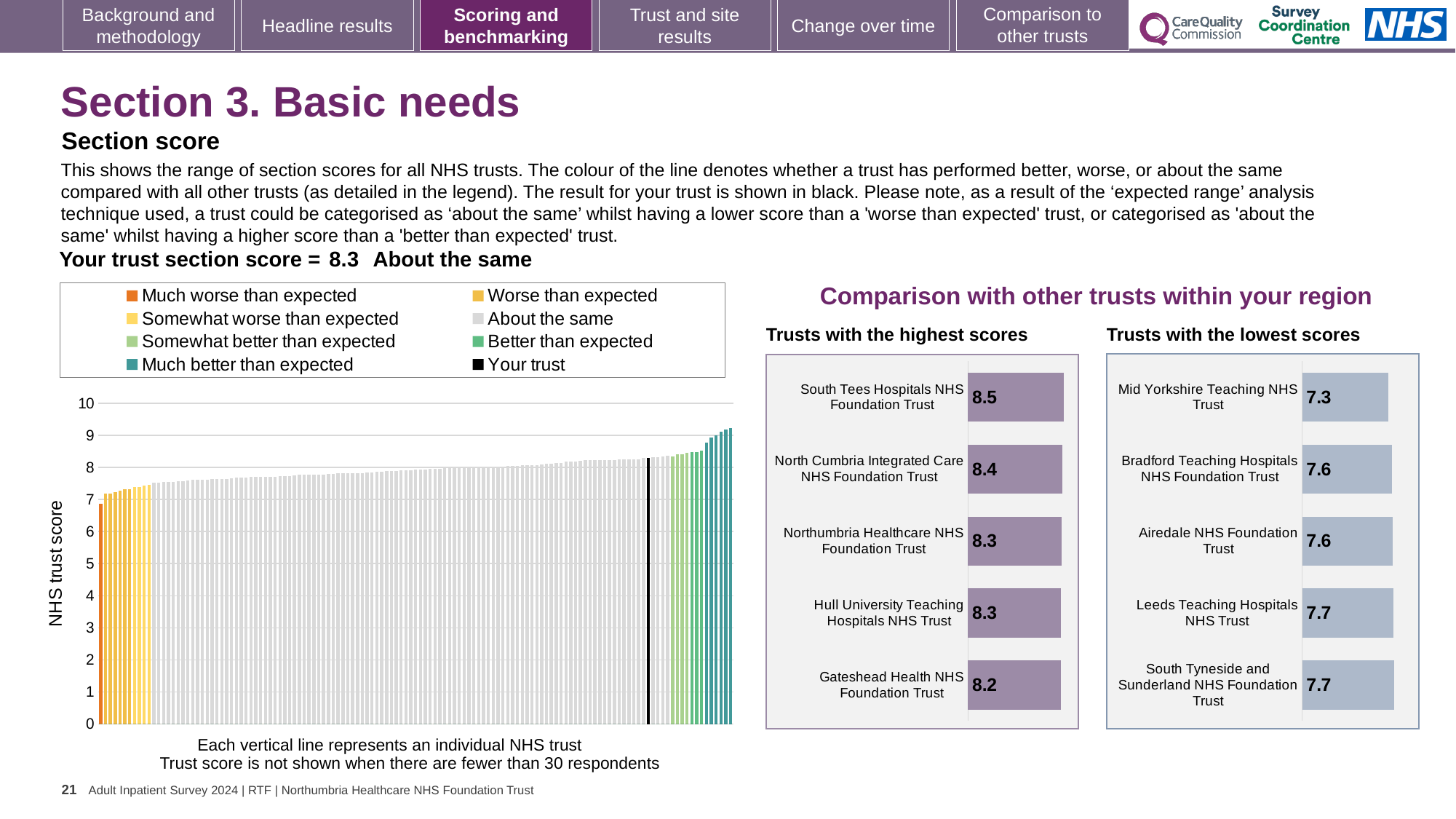
In the NHS trust score chart on the left, do the values rise or fall from left to right along the x axis? Rise In the 'Trusts with the highest scores' chart, what is the difference between the scores of South Tees Hospitals NHS Foundation Trust and Gateshead Health NHS Foundation Trust? 0.3 In the 'Trusts with the highest scores' chart, which trust has the highest score? South Tees Hospitals NHS Foundation Trust How many trusts are shown in the 'Trusts with the lowest scores' chart? 5 In the 'Trusts with the lowest scores' chart, which has the larger score: Mid Yorkshire Teaching NHS Trust or Bradford Teaching Hospitals NHS Foundation Trust? Bradford Teaching Hospitals NHS Foundation Trust In the 'Trusts with the lowest scores' chart, what is the score for Leeds Teaching Hospitals NHS Trust? 7.7 How many entries does the legend of the NHS trust score chart on the left list? 8 In the 'Trusts with the lowest scores' chart, what is the score for Mid Yorkshire Teaching NHS Trust? 7.3 What kind of chart is the NHS trust score chart on the left of the slide? Bar chart In the 'Trusts with the highest scores' chart, what is the score for Gateshead Health NHS Foundation Trust? 8.2 In the 'Trusts with the highest scores' chart, what is the score for South Tees Hospitals NHS Foundation Trust? 8.5 In the 'Trusts with the lowest scores' chart, which trust has the lowest score? Mid Yorkshire Teaching NHS Trust